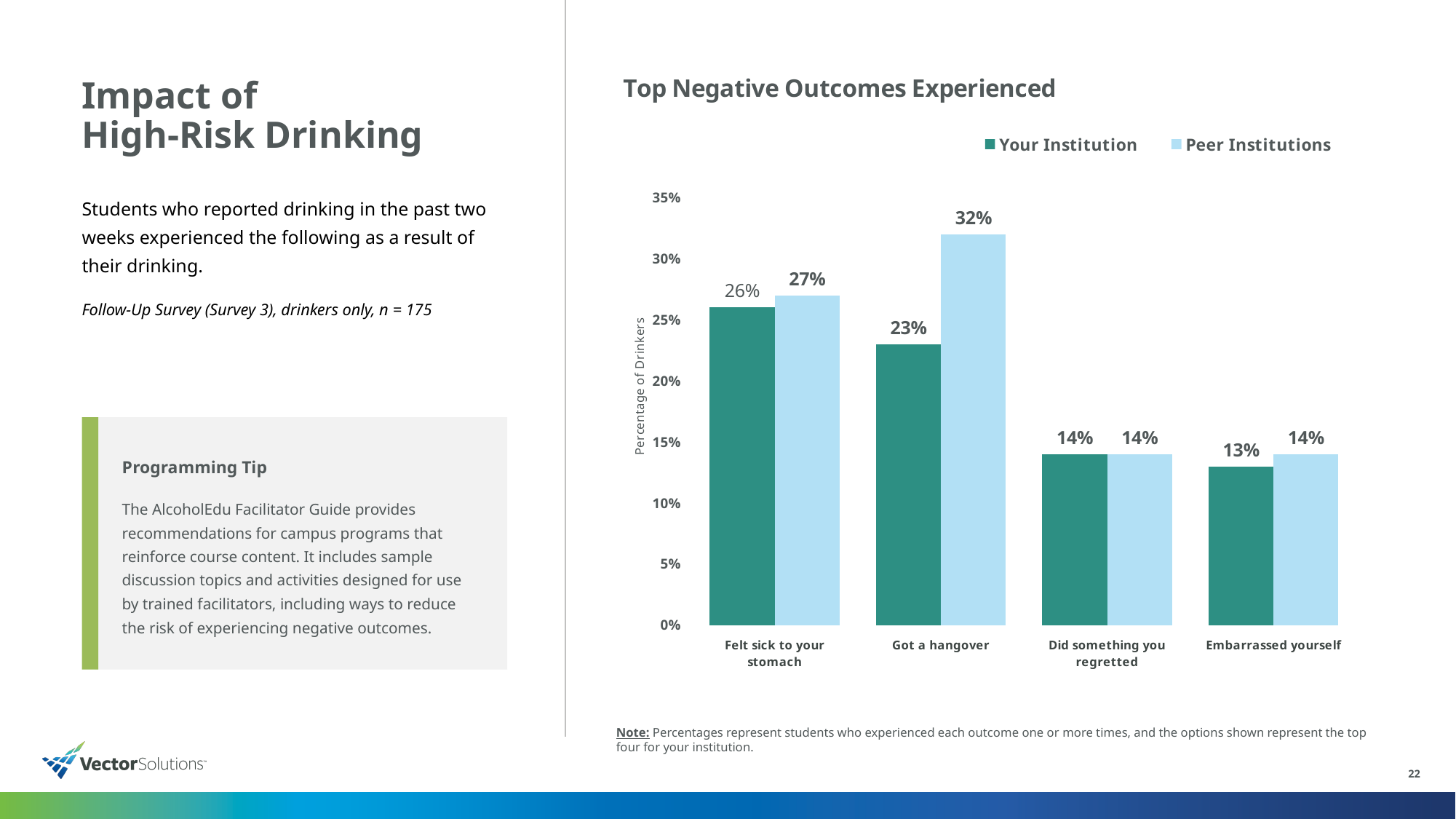
How many categories are shown on the x axis? 4 What is the value for Your Institution for "Felt sick to your stomach"? 26% What is the difference between Peer Institutions and Your Institution for "Got a hangover"? 9% Which category has the highest value for Peer Institutions? Got a hangover Which category has the lowest value for Your Institution? Embarrassed yourself How many series does the legend list? 2 What is the title of the chart? Top Negative Outcomes Experienced What is the value for Your Institution for "Embarrassed yourself"? 13% Is the value for Your Institution for "Got a hangover" greater or less than 20%? greater What is the value for Peer Institutions for "Got a hangover"? 32% For "Felt sick to your stomach", which is larger: Your Institution or Peer Institutions? Peer Institutions What kind of chart is shown? Bar chart